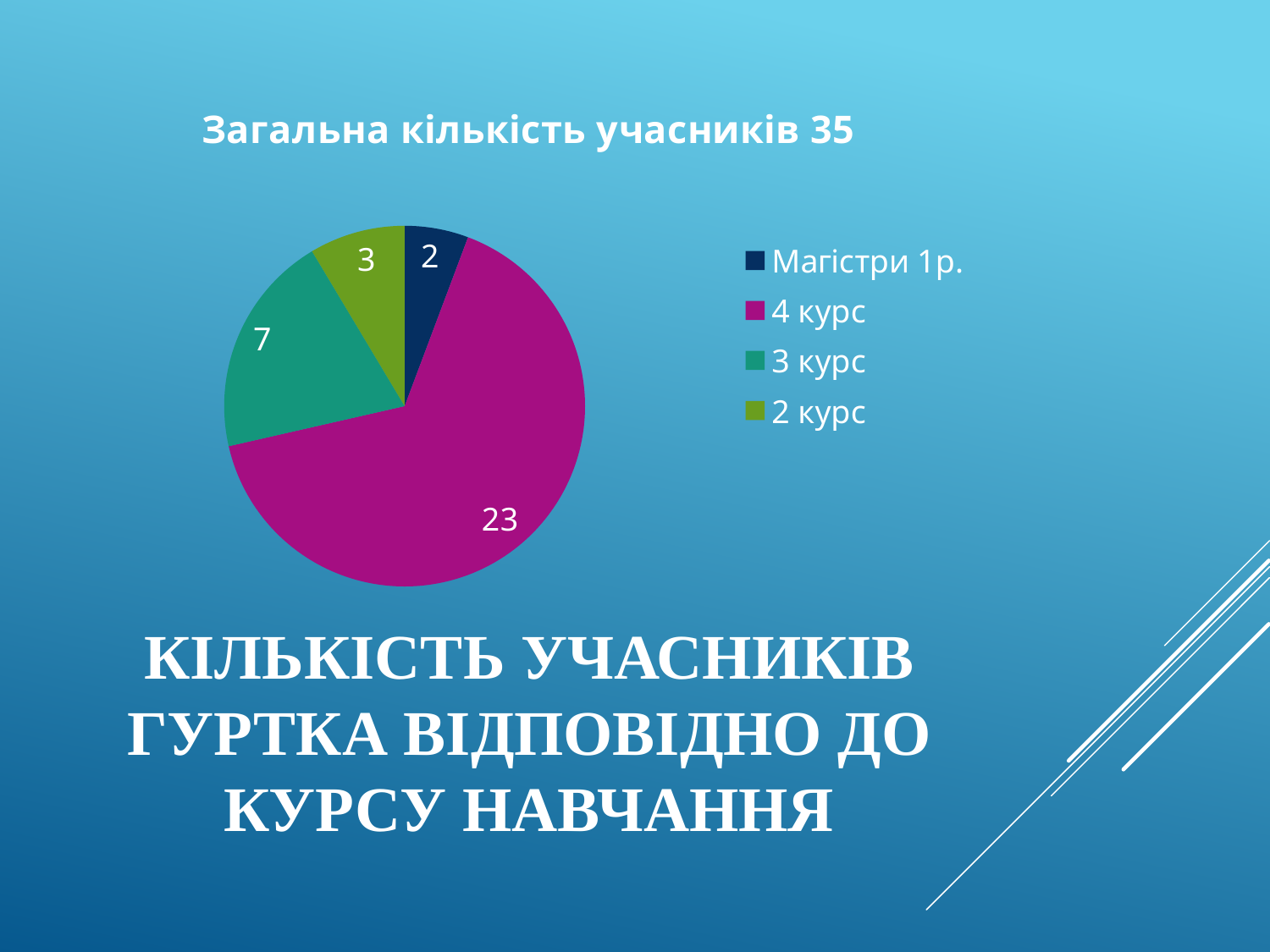
Which category has the smallest slice of the pie? Магістри 1р. What kind of chart is shown on the slide? pie chart Which is larger, the value for 3 курс or the value for 2 курс? 3 курс What is the value for 2 курс? 3 What is the value for 4 курс? 23 How many categories does the pie chart have? 4 Which category has the largest slice of the pie? 4 курс What is the difference between the values for 4 курс and 3 курс? 16 What is the value for Магістри 1р.? 2 What is the title of the chart? Загальна кількість учасників 35 What is the value for 3 курс? 7 What is the total of all slices in the pie chart? 35